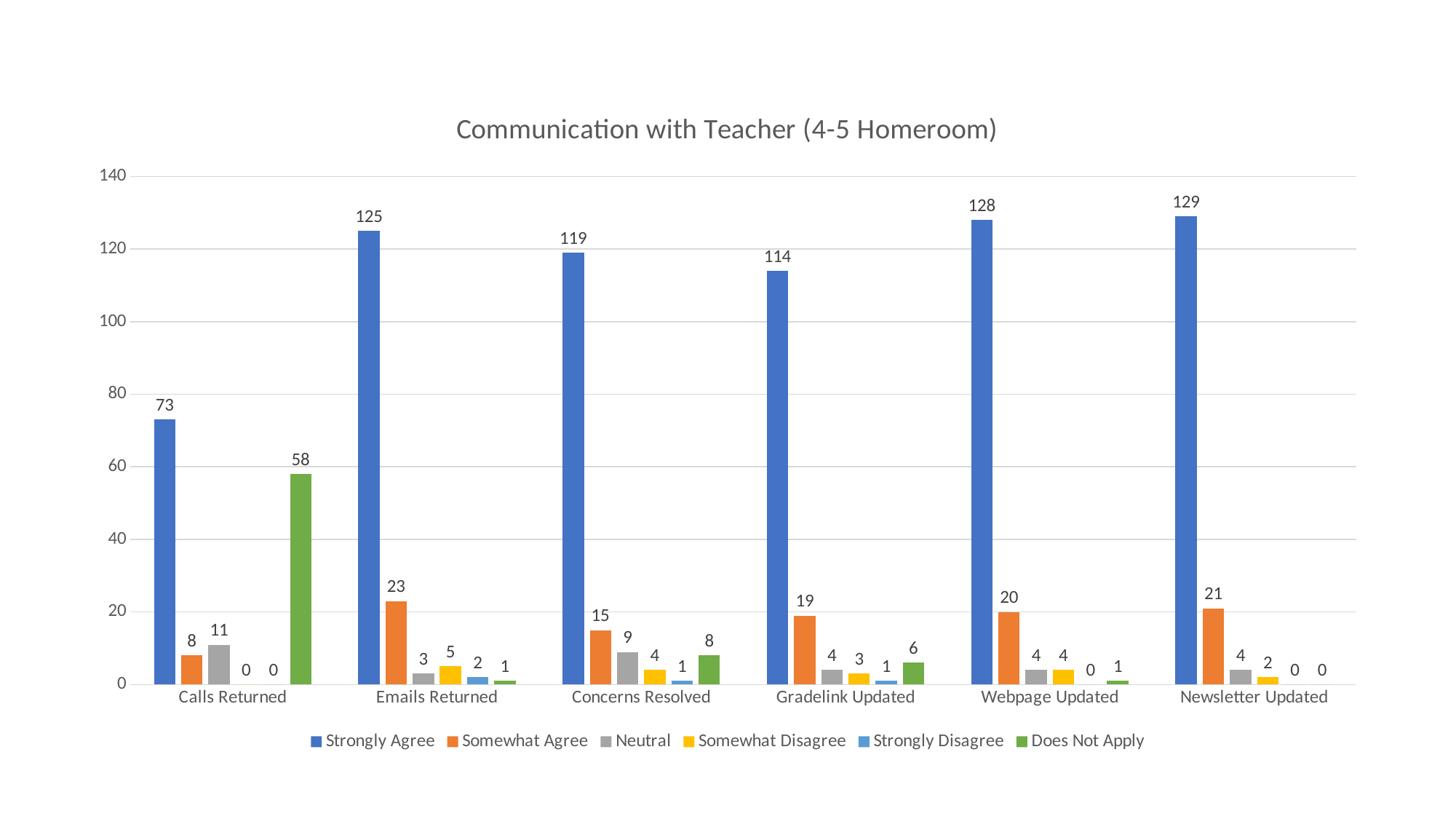
How many series does the legend list? 6 How many categories are shown on the x axis? 6 Which category has the lowest Strongly Agree value? Calls Returned Is the Strongly Agree value for Gradelink Updated greater or less than 100? greater Which is larger, the Somewhat Agree value for Emails Returned or for Gradelink Updated? Emails Returned What kind of chart is this? bar chart What is the Strongly Agree value for Emails Returned? 125 Which category has the highest Strongly Agree value? Newsletter Updated What is the Somewhat Agree value for Webpage Updated? 20 What is the difference between the Strongly Agree values for Newsletter Updated and Calls Returned? 56 What is the title of the chart? Communication with Teacher (4-5 Homeroom) What is the Does Not Apply value for Calls Returned? 58